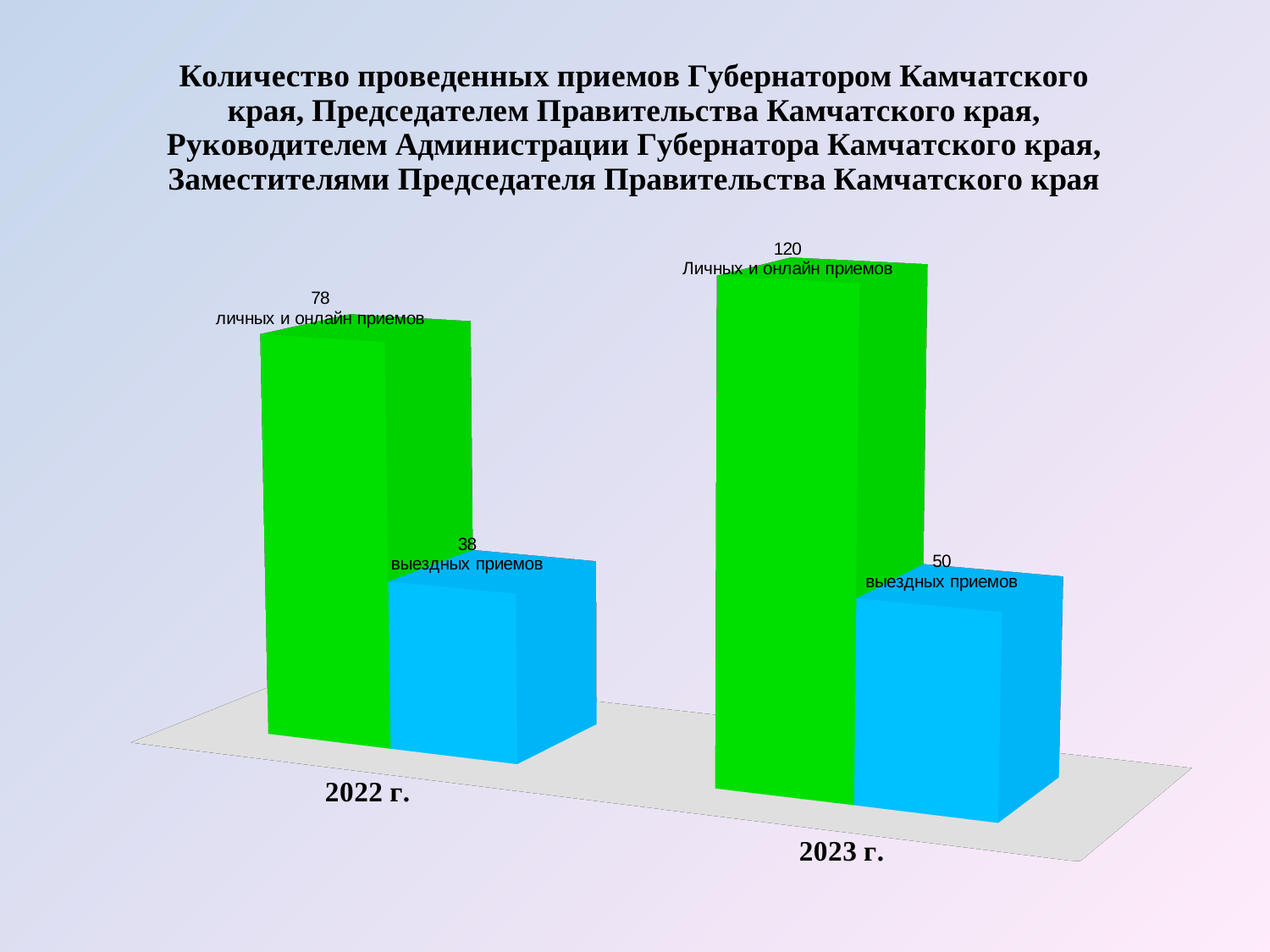
In the 2023 г. chart, how many личных и онлайн приемов were held? 120 In the 2023 г. chart, which category has the higher value? Личных и онлайн приемов In the 2022 г. chart, how many личных и онлайн приемов were held? 78 Which is larger: выездных приемов in the 2022 г. chart or выездных приемов in the 2023 г. chart? 2023 г. In the 2023 г. chart, how many выездных приемов were held? 50 In the 2022 г. chart, how many выездных приемов were held? 38 In the 2022 г. chart, which category has the lower value? выездных приемов What colour are the bars for выездных приемов? Blue What is the total of the two values shown in the 2023 г. chart? 170 What is the difference between личных и онлайн приемов and выездных приемов in the 2022 г. chart? 40 What type of chart is used on the slide? Bar chart By how much did the number of личных и онлайн приемов increase from the 2022 г. chart to the 2023 г. chart? 42